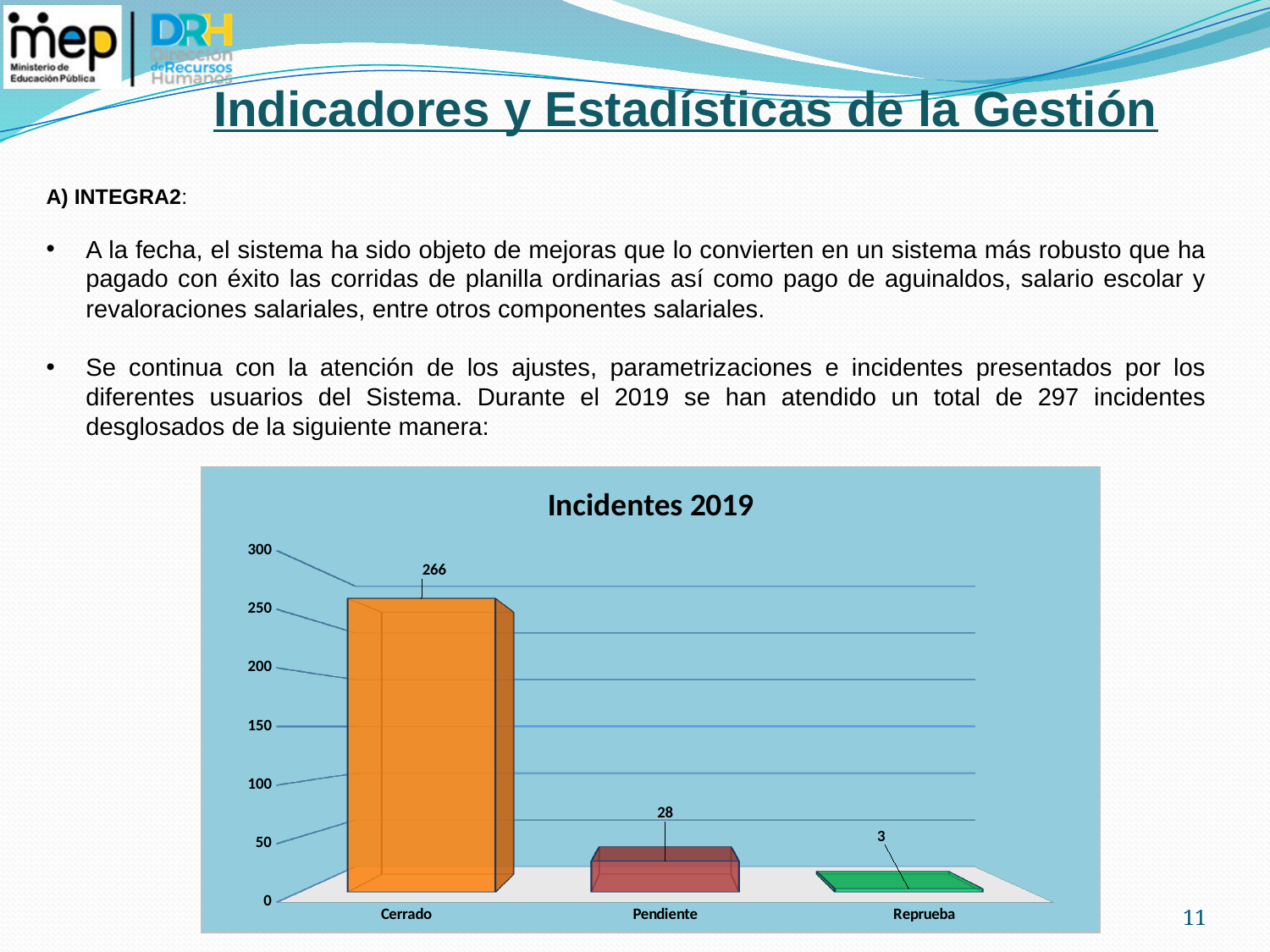
What is the difference between the values for Cerrado and Pendiente in the Incidentes 2019 chart? 238 What is the title of the chart on the slide? Incidentes 2019 Is the value for Cerrado in the Incidentes 2019 chart greater or less than 250? greater Which category has the lowest value in the Incidentes 2019 chart? Reprueba What is the difference between the values for Pendiente and Reprueba in the Incidentes 2019 chart? 25 What kind of chart is the Incidentes 2019 chart? bar chart Which category has the highest value in the Incidentes 2019 chart? Cerrado How many categories are shown in the Incidentes 2019 chart? 3 What is the value for Reprueba in the Incidentes 2019 chart? 3 Which is larger in the Incidentes 2019 chart, Pendiente or Reprueba? Pendiente What is the value for Pendiente in the Incidentes 2019 chart? 28 What is the value for Cerrado in the Incidentes 2019 chart? 266